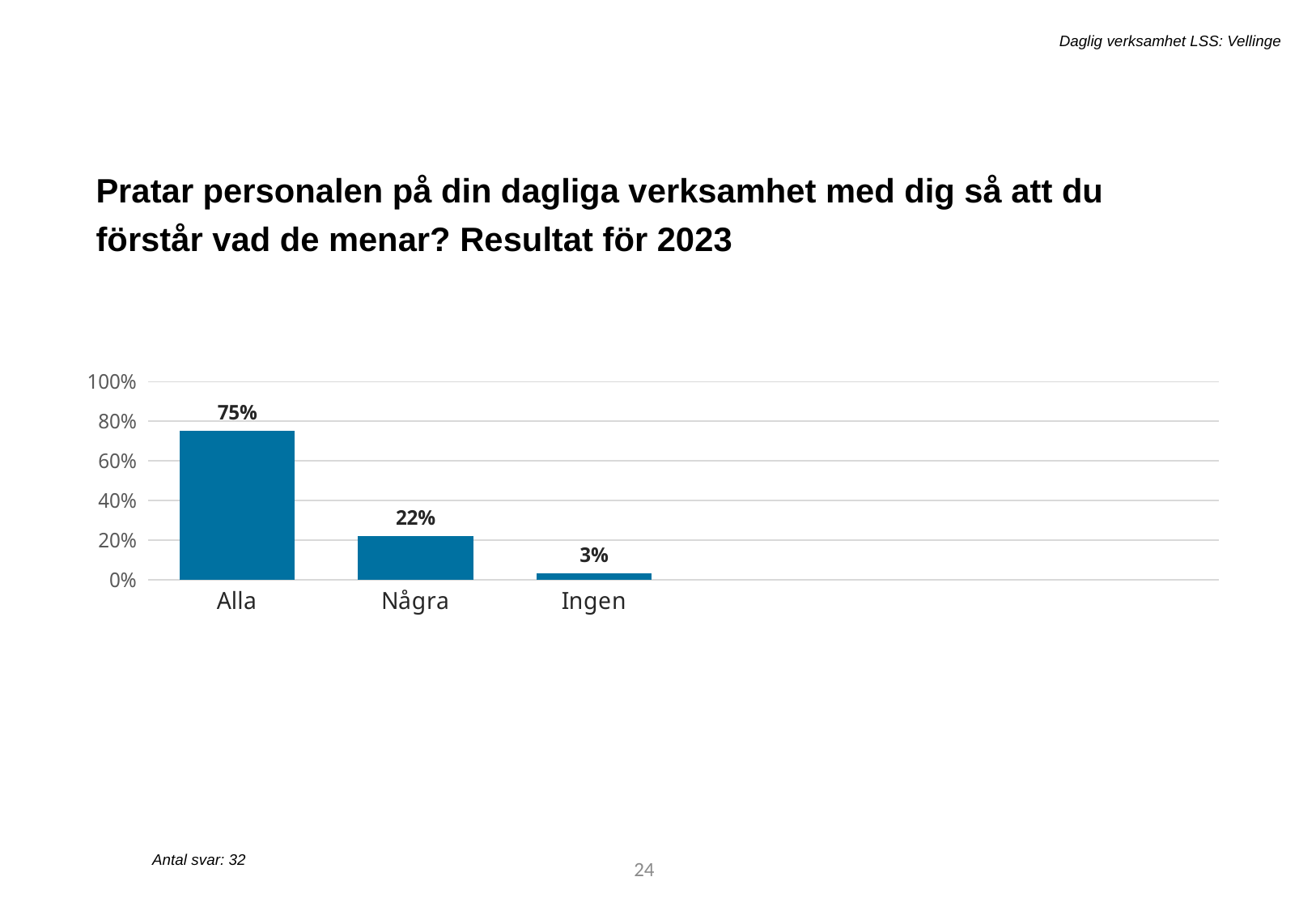
What is the value for Några? 22% Which is larger, the value for Några or the value for Ingen? Några What is the difference between the values for Några and Ingen? 19% Is the value for Alla greater or less than 60%? greater What is the difference between the values for Alla and Några? 53% Which category has the lowest value? Ingen Which category has the highest value? Alla What is the value for Ingen? 3% How many categories are shown on the x axis? 3 What is the value for Alla? 75% What kind of chart is shown on the slide? bar chart Do the values rise or fall from left to right along the x axis? fall